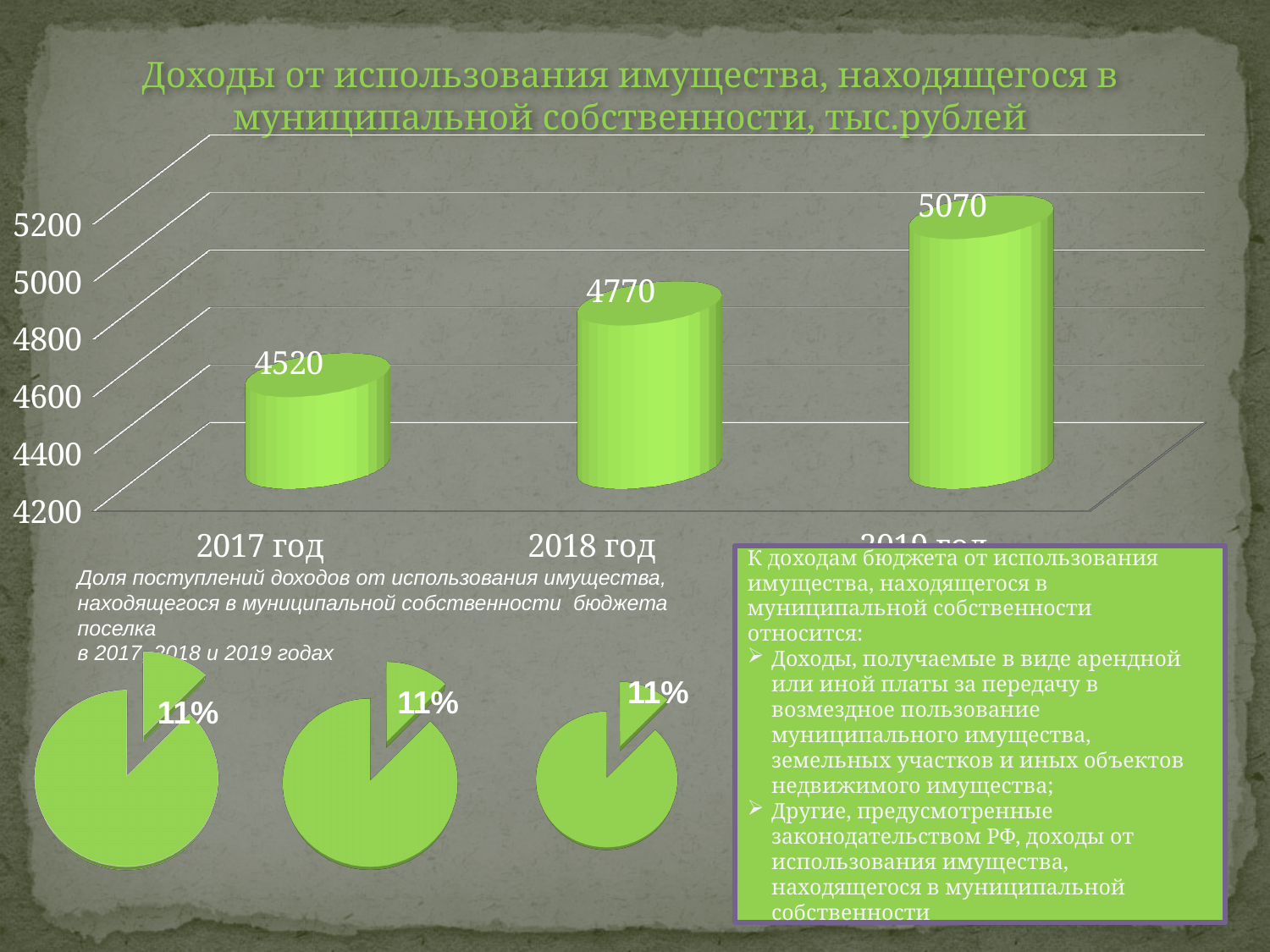
In the bar chart, which year has the lowest value? 2017 год In the bar chart, what is the difference between the values for 2018 год and 2017 год? 250 In the bar chart, what is the difference between the values for 2019 год and 2018 год? 300 In the bar chart, is the value for 2018 год greater or less than 5000? less In the bar chart, what is the value for 2018 год? 4770 How many bars does the bar chart show? 3 In the bar chart, which is larger: the value for 2017 год or the value for 2018 год? 2018 год In the bar chart, what is the value for the third (rightmost) bar, 2019 год? 5070 In the bar chart, what is the value for 2017 год? 4520 In the leftmost pie chart at the bottom of the slide, what share is shown for the highlighted slice? 11% Do the values in the bar chart rise or fall from 2017 to 2019? rise In the bar chart, which year has the highest value? 2019 год